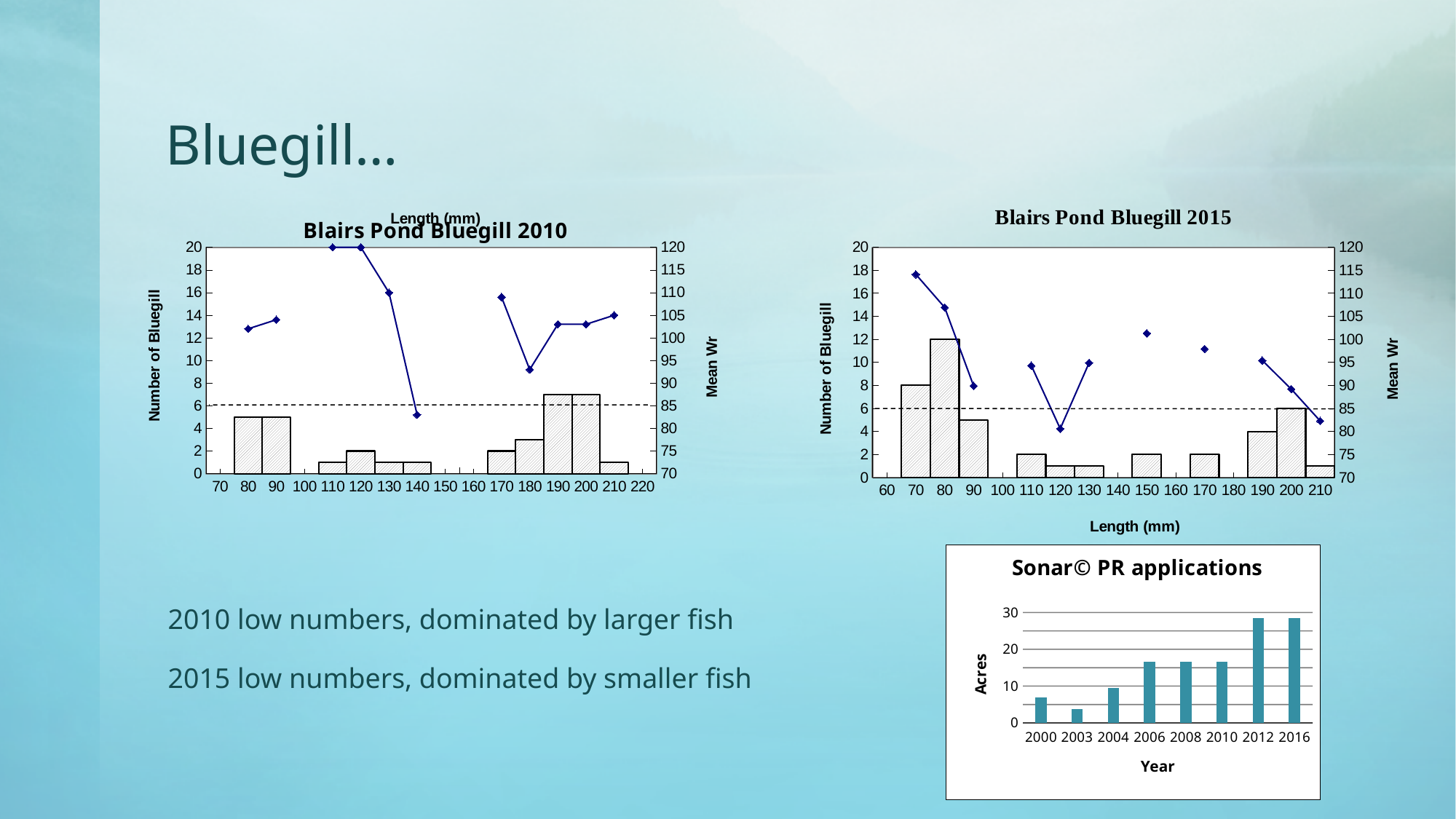
In the Blairs Pond Bluegill 2015 chart, at which length is the Mean Wr point lowest? 120 In the Sonar© PR applications chart, how many years are shown on the x axis? 8 In the Blairs Pond Bluegill 2015 chart, how many bluegill are in the 70 mm length group? 8 In the Sonar© PR applications chart, which year has the lowest acres? 2003 In the Blairs Pond Bluegill 2010 chart, what is the Mean Wr value at 110 mm? 120 In the Blairs Pond Bluegill 2015 chart, which length group has the highest number of bluegill? 80 In the Blairs Pond Bluegill 2010 chart, is the number of bluegill in the 190 mm group greater or less than 6? greater In the Blairs Pond Bluegill 2015 chart, what is the difference in number of bluegill between the 80 mm and 70 mm groups? 4 In the Blairs Pond Bluegill 2015 chart, which has more bluegill, the 190 mm group or the 200 mm group? 200 In the Blairs Pond Bluegill 2010 chart, how many bluegill are in the 120 mm length group? 2 In the Blairs Pond Bluegill 2015 chart, how many bluegill are in the 80 mm length group? 12 In the Sonar© PR applications chart, is the value for 2012 greater or less than 20? greater